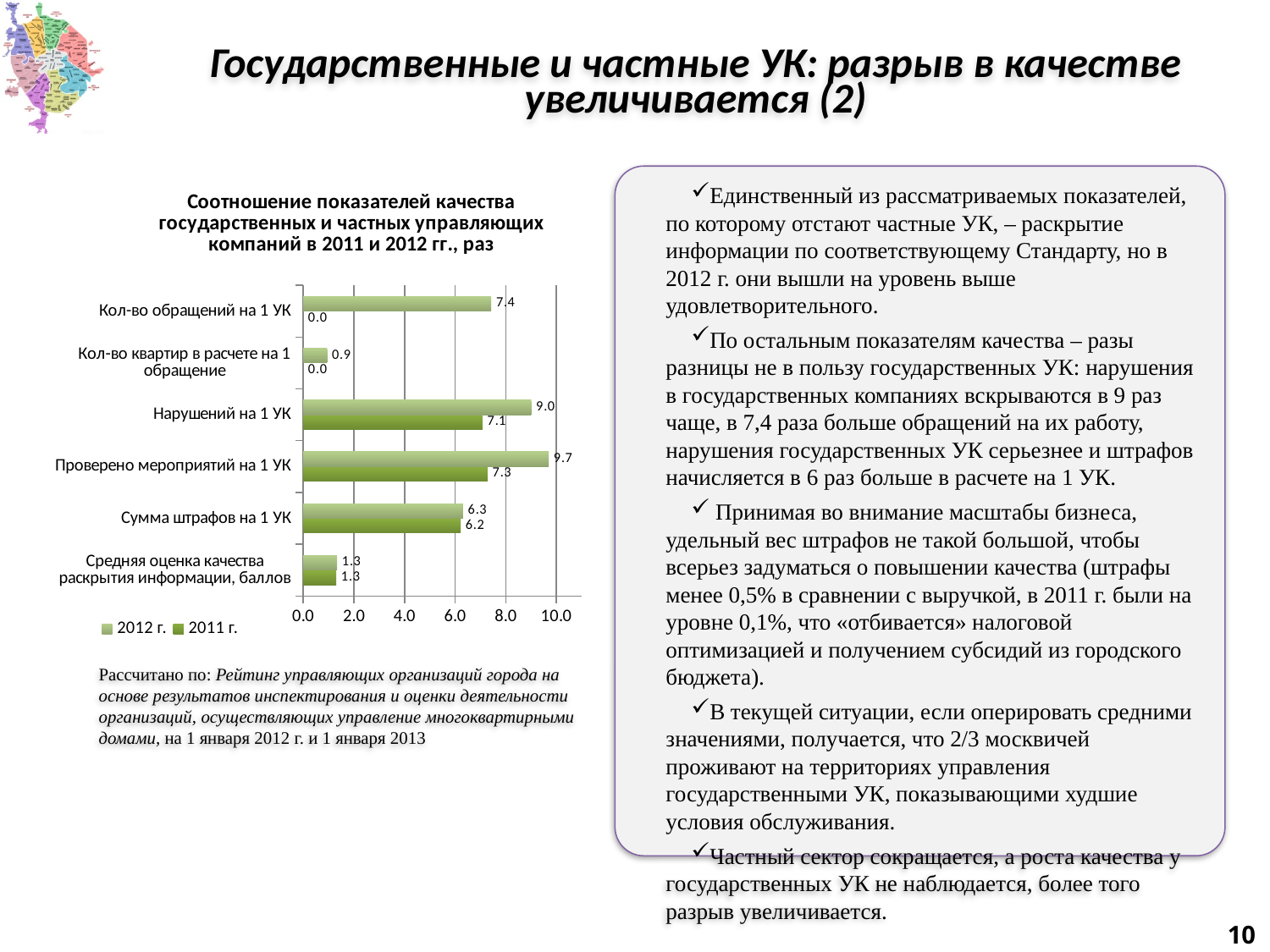
What is the 2012 г. value for "Проверено мероприятий на 1 УК"? 9.7 What is the difference between the 2012 г. and 2011 г. values for "Проверено мероприятий на 1 УК"? 2.4 Which category has the highest 2012 г. value? Проверено мероприятий на 1 УК What type of chart is shown on the slide? bar chart Which category has the lowest 2012 г. value? Кол-во квартир в расчете на 1 обращение Which series is shown in the lighter green colour in the legend? 2012 г. Which is larger for "Нарушений на 1 УК": the 2012 г. value or the 2011 г. value? 2012 г. How many categories are plotted on the chart? 6 How many series does the chart legend list? 2 What is the 2012 г. value for "Кол-во обращений на 1 УК"? 7.4 What is the 2011 г. value for "Нарушений на 1 УК"? 7.1 What is the 2011 г. value for "Сумма штрафов на 1 УК"? 6.2